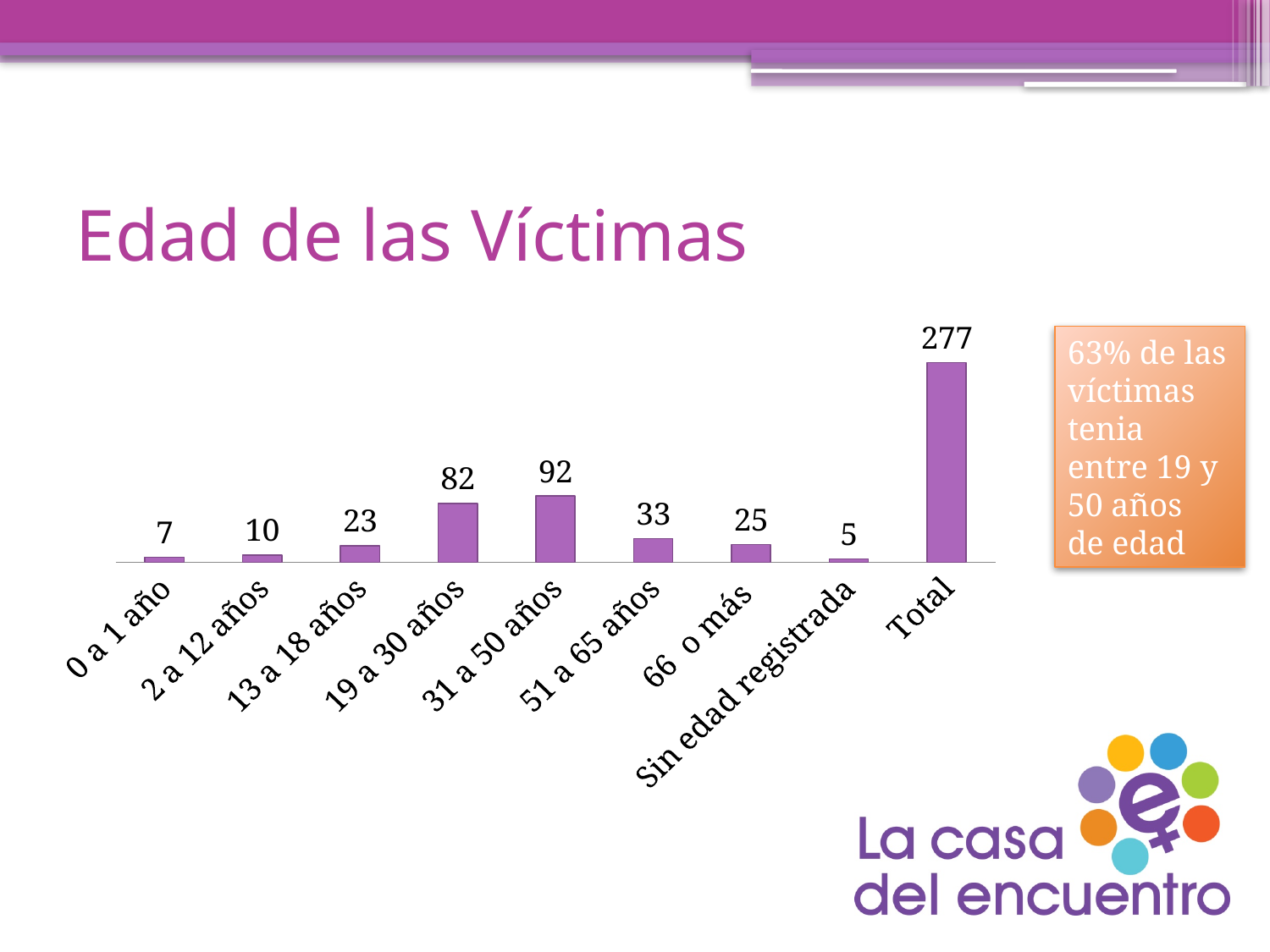
What kind of chart is shown on the slide? bar chart How many categories are shown on the x axis, including Total? 9 What is the value for the Sin edad registrada category? 5 What is the value shown for Total? 277 Excluding the Total bar, which age category has the highest value? 31 a 50 años What is the difference between the values for 31 a 50 años and 19 a 30 años? 10 What is the value for the 19 a 30 años category? 82 What is the difference between the values for 13 a 18 años and 2 a 12 años? 13 Which is larger, the value for 51 a 65 años or the value for 66 o más? 51 a 65 años What is the title of the slide containing the chart? Edad de las Víctimas What is the value for the 31 a 50 años category? 92 Which category has the lowest value? Sin edad registrada